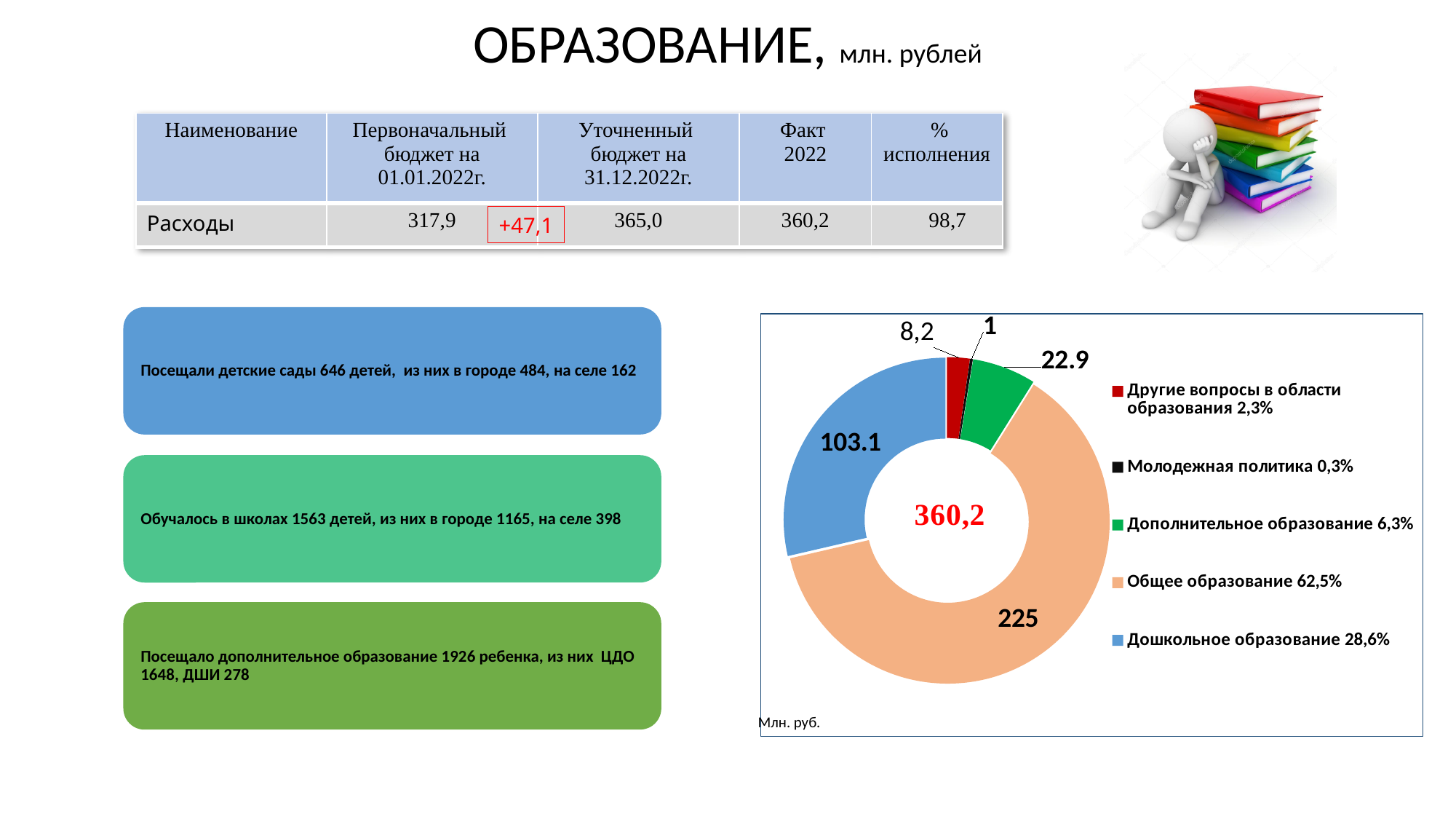
What is the value for Дополнительное образование in the doughnut chart? 22.9 Which category has the smallest slice in the doughnut chart? Молодежная политика What is the value for Дошкольное образование in the doughnut chart? 103.1 How many slices does the doughnut chart have? 5 What is the value for Молодежная политика in the doughnut chart? 1 What share of the doughnut chart does Дошкольное образование represent? 28,6% What is the value for Общее образование in the doughnut chart? 225 What total value is shown in the centre of the doughnut chart? 360,2 Which category has the largest slice in the doughnut chart? Общее образование What is the value for Другие вопросы в области образования in the doughnut chart? 8,2 What kind of chart is shown on the slide? doughnut (pie) chart Which is larger in the doughnut chart: Дополнительное образование or Другие вопросы в области образования? Дополнительное образование